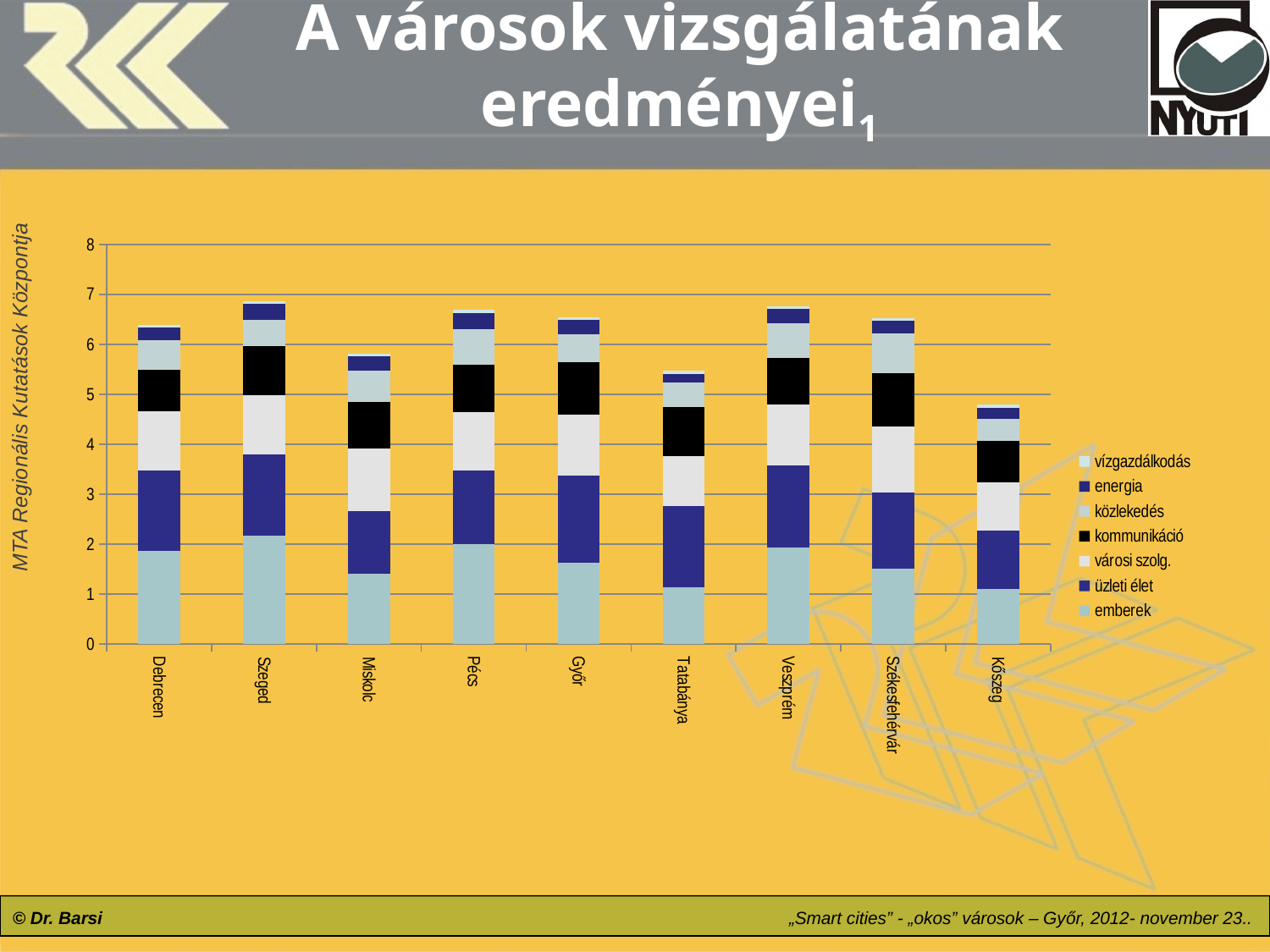
Which city has the lowest total stacked bar? Kőszeg Is the total stacked value for Kőszeg greater or less than 5? less Which series is shown in black in the chart? kommunikáció How many cities are shown on the x axis of the chart? 9 What kind of chart is shown on the slide? stacked bar chart Which city has the larger total stacked bar, Miskolc or Pécs? Pécs Which series is listed first in the chart's legend? vízgazdálkodás Is the total stacked value for Debrecen greater or less than 6? greater Is the total stacked value for Tatabánya greater or less than 5? greater How many series does the chart's legend list? 7 Which city has the larger total stacked bar, Tatabánya or Kőszeg? Tatabánya